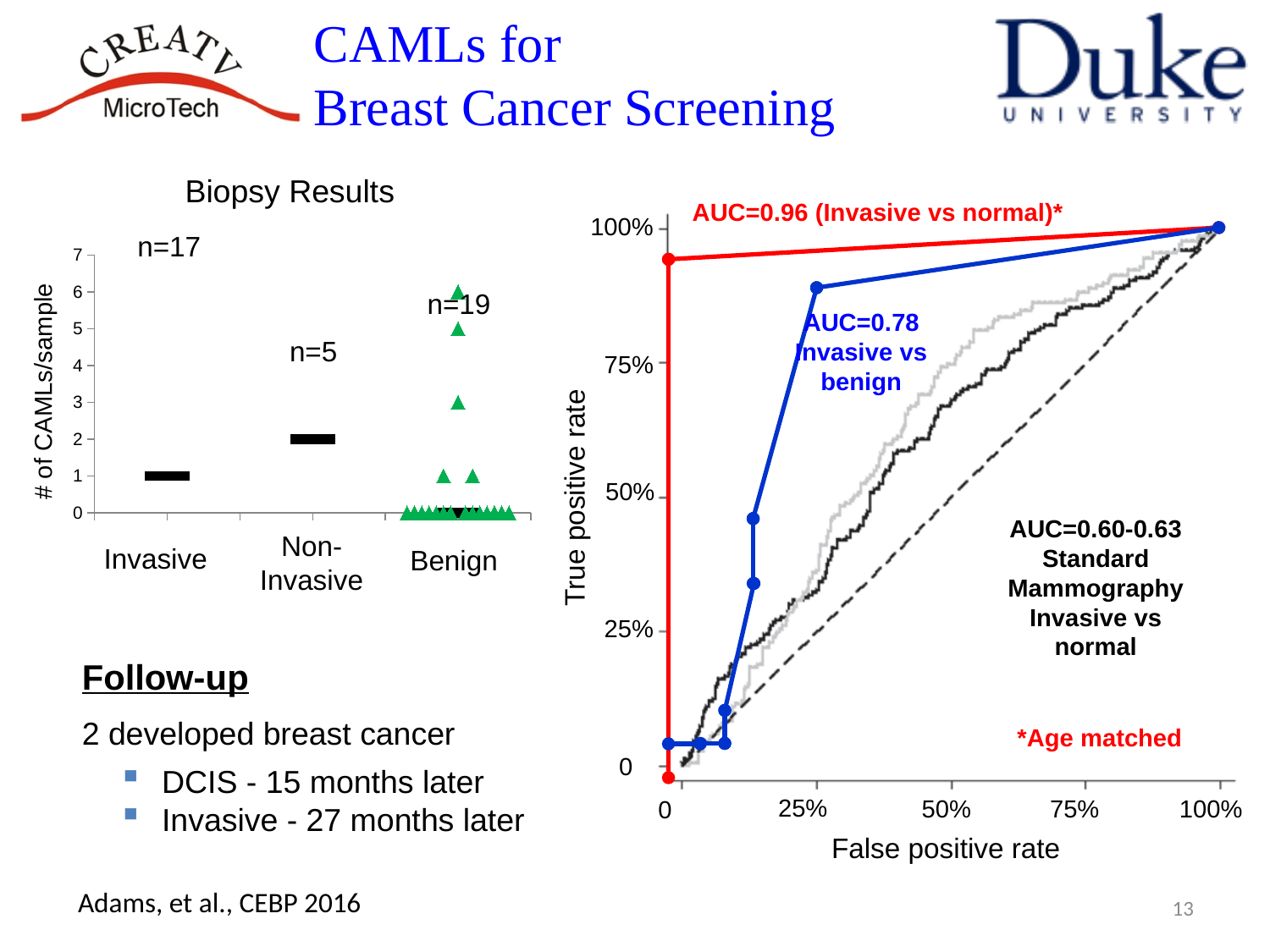
In the Biopsy Results chart, what is the label of the y axis? # of CAMLs/sample In the Biopsy Results chart, what is the sample size (n) for the Invasive group? n=17 In the Biopsy Results chart, what is the sample size (n) for the Non-Invasive group? n=5 In the Biopsy Results chart, what is the sample size (n) for the Benign group? n=19 In the ROC chart on the right, what is the AUC for Invasive vs normal? 0.96 In the Biopsy Results chart, how many biopsy categories are shown on the x axis? 3 In the ROC chart on the right, which comparison has the higher AUC, Invasive vs normal or Invasive vs benign? Invasive vs normal In the Biopsy Results chart, how many more samples are in the Benign group than in the Invasive group? 2 In the ROC chart on the right, what AUC range is given for Standard Mammography (Invasive vs normal)? 0.60-0.63 In the Biopsy Results chart, which group has the largest sample size? Benign In the ROC chart on the right, what is the AUC for Invasive vs benign? 0.78 In the Biopsy Results chart, which group has the smallest sample size? Non-Invasive